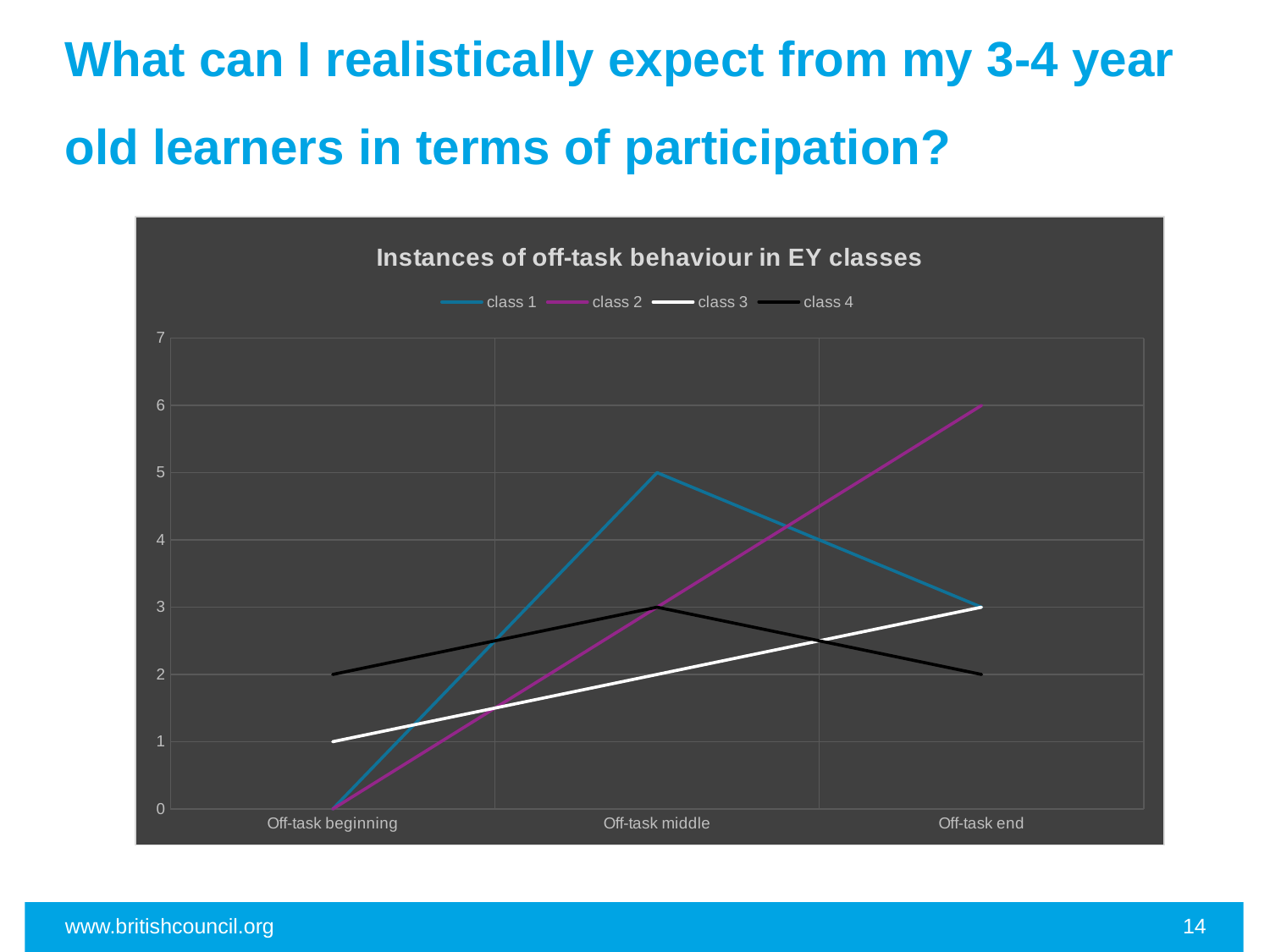
What is the difference between class 2 and class 4 at Off-task end? 4 What is the value for class 2 at Off-task end? 6 What is the value for class 1 at Off-task middle? 5 What is the value for class 4 at Off-task beginning? 2 How many categories are shown on the x axis? 3 Do the values for class 3 rise or fall from Off-task beginning to Off-task end? rise What kind of chart is shown on the slide? line chart Which class has the lowest value at Off-task middle? class 3 Which is larger at Off-task middle, class 1 or class 2? class 1 Which class has the highest value at Off-task end? class 2 What is the title of the chart? Instances of off-task behaviour in EY classes How many series does the legend list? 4